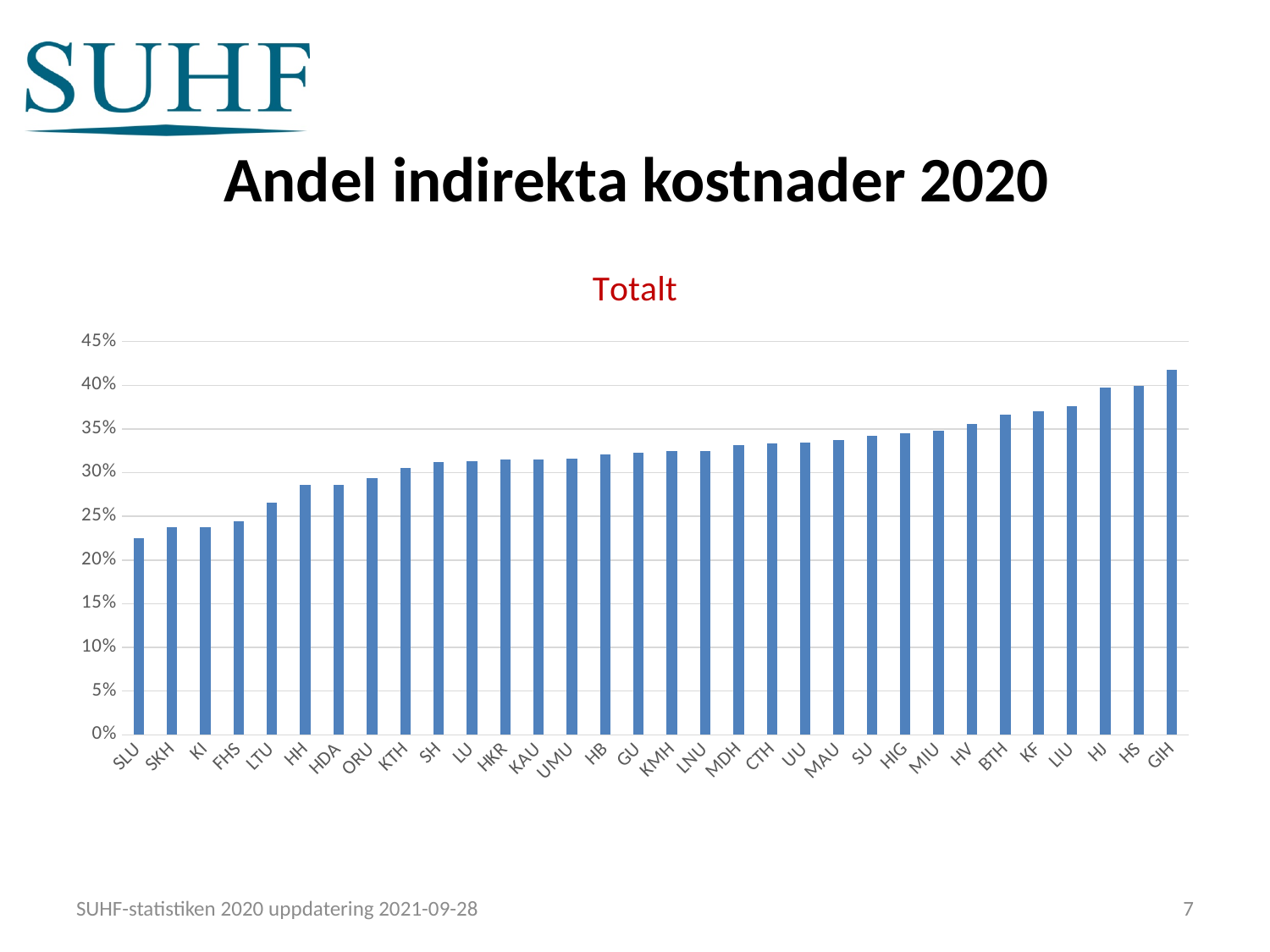
Which category has the lowest value? SLU Is the value for UU greater or less than 30%? greater Is the value for GIH greater or less than 40%? greater Is the value for SLU greater or less than 25%? less Which category has the highest value? GIH How many categories (bars) are shown on the x axis? 32 Do the values generally rise or fall from left to right along the x axis? Rise Which has a larger value, LTU or LIU? LIU What is the title shown directly above the chart? Totalt What kind of chart is shown on the slide? Bar chart